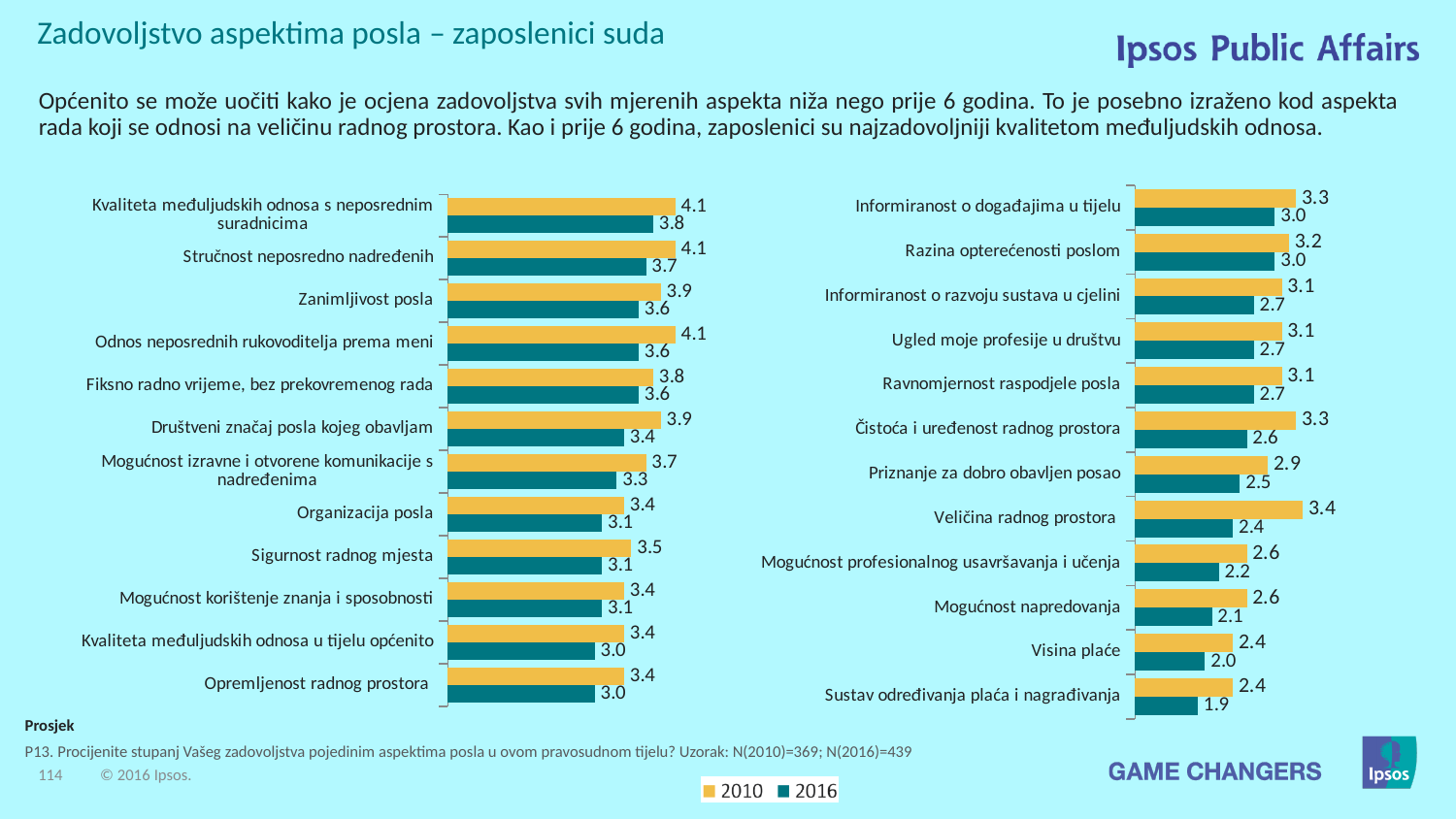
How many categories are shown on the left chart? 12 On the right chart, what is the difference between the 2010 and 2016 values for Veličina radnog prostora? 1.0 On the left chart, what is the 2010 value for Sigurnost radnog mjesta? 3.5 On the right chart, what is the 2016 value for Sustav određivanja plaća i nagrađivanja? 1.9 On the right chart, which is larger: the 2016 value for Visina plaće or the 2016 value for Mogućnost napredovanja? Visina plaće What type of chart is used on the slide? Bar chart On the right chart, which category has the lowest 2016 value? Sustav određivanja plaća i nagrađivanja How many series does the legend list? 2 On the left chart, what is the 2016 value for Zanimljivost posla? 3.6 On the left chart, what is the difference between the 2010 and 2016 values for Društveni značaj posla kojeg obavljam? 0.5 On the right chart, what is the 2010 value for Veličina radnog prostora? 3.4 On the left chart, which category has the highest 2016 value? Kvaliteta međuljudskih odnosa s neposrednim suradnicima